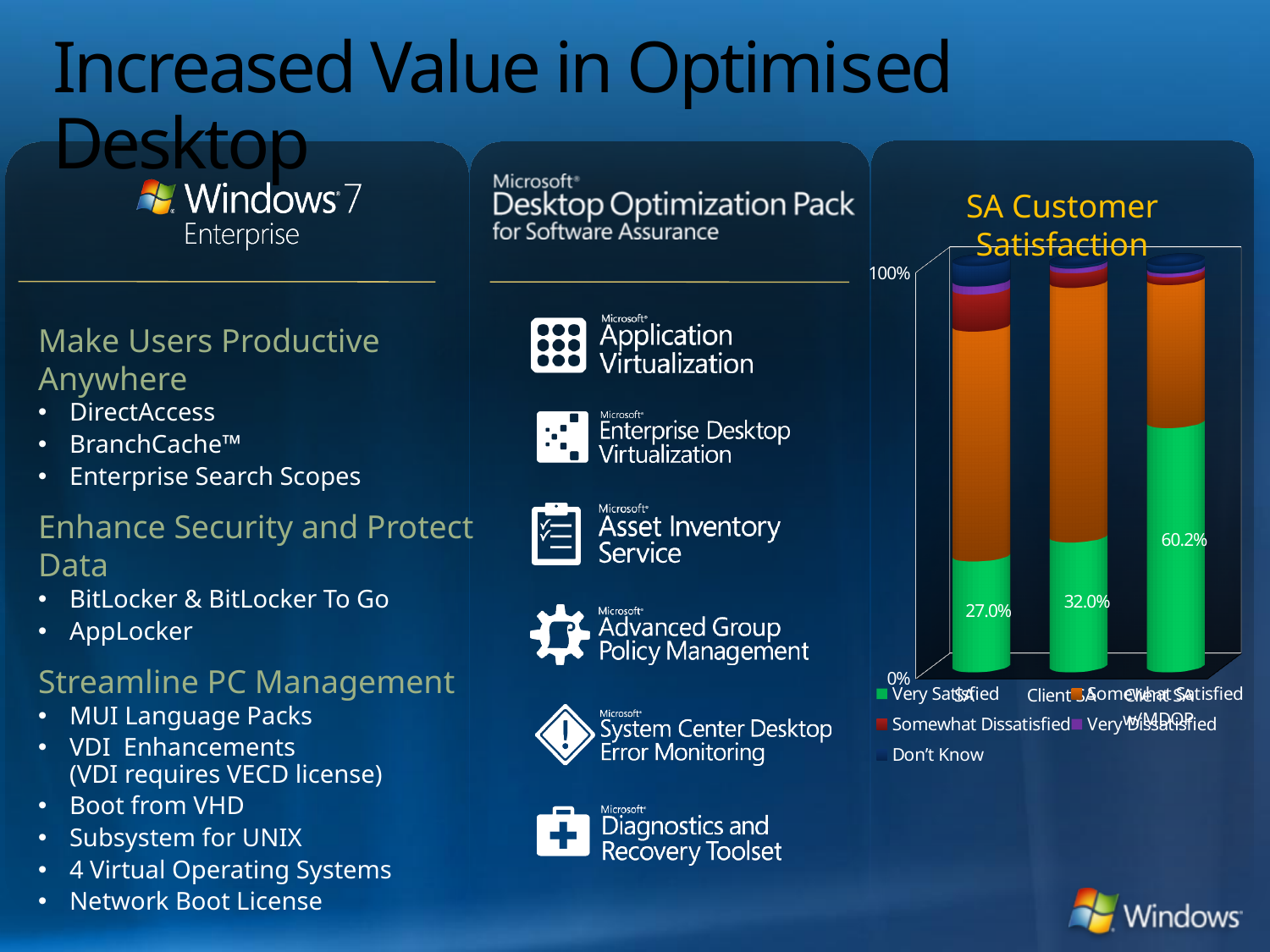
In the SA Customer Satisfaction chart, which category has the lowest Very Satisfied value? SA In the SA Customer Satisfaction chart, do the Very Satisfied values rise or fall from left to right? Rise How many series does the legend of the SA Customer Satisfaction chart list? 5 What is the title of the chart on the right of the slide? SA Customer Satisfaction In the SA Customer Satisfaction chart, which category has the highest Very Satisfied value? Client SA w/MDOP In the SA Customer Satisfaction chart, what is the difference between the Very Satisfied values for Client SA w/MDOP and Client SA? 28.2% In the SA Customer Satisfaction chart, what is the Very Satisfied value for Client SA w/MDOP? 60.2% In the SA Customer Satisfaction chart, which has the larger Very Satisfied value, SA or Client SA? Client SA In the SA Customer Satisfaction chart, what is the Very Satisfied value for Client SA? 32.0% What kind of chart is the SA Customer Satisfaction chart? Stacked bar chart In the SA Customer Satisfaction chart, what is the Very Satisfied value for SA? 27.0% How many bars are plotted in the SA Customer Satisfaction chart? 3